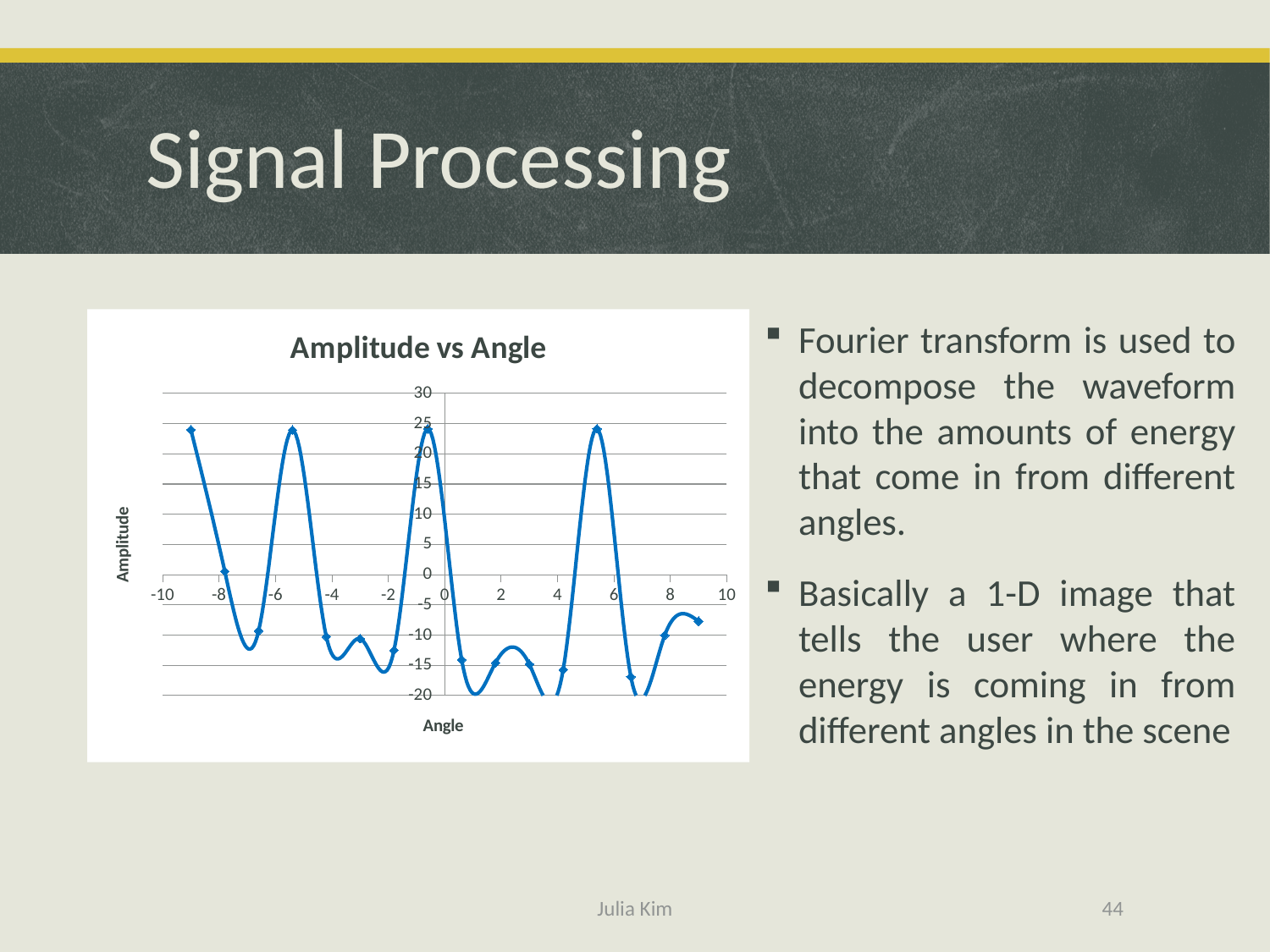
What is the label of the vertical axis of the chart? Amplitude Is the amplitude at angle 1 greater or less than -10? less Is the amplitude at angle 9 greater or less than 0? less Does the amplitude rise or fall between angle -9 and angle -8? fall What kind of chart is shown on the slide? line chart Is the amplitude at angle -8 greater or less than 10? less Which has the larger amplitude, angle -8 or angle 1? angle -8 Which has the larger amplitude, angle -9 or angle -4? angle -9 What is the title of the chart? Amplitude vs Angle